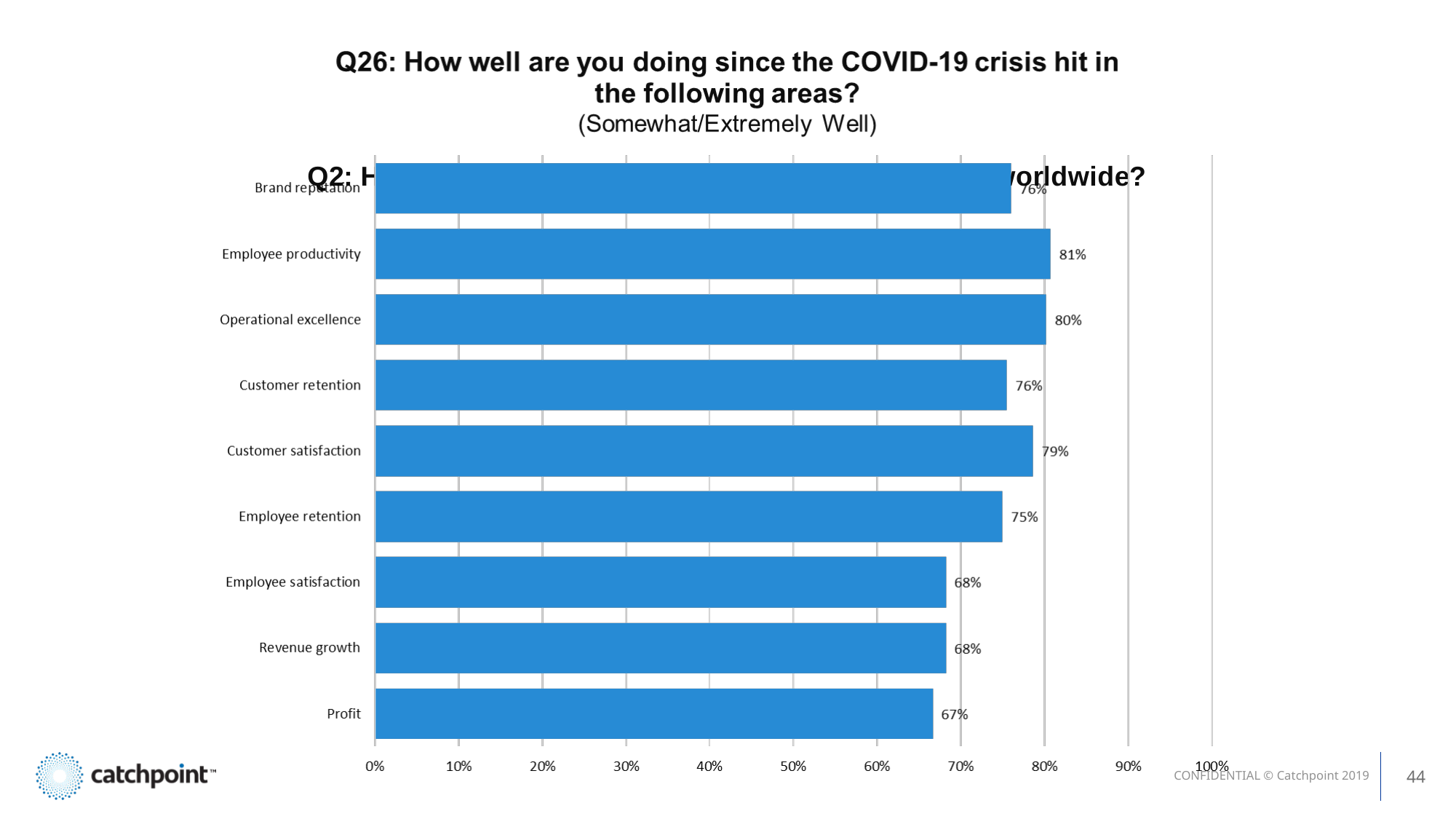
Is the value for Revenue growth greater or less than 70%? less What is the difference between Employee productivity and Profit? 14% What kind of chart is shown on the slide? Bar chart What percentage is shown for Employee productivity? 81% What percentage is shown for Customer satisfaction? 79% How many areas are shown in the chart? 9 Which area has the lowest percentage? Profit What is the difference between Customer satisfaction and Employee retention? 4% What is the value for Profit? 67% Which is larger, Customer retention or Employee satisfaction? Customer retention Which area has the highest percentage? Employee productivity What is the value for Operational excellence? 80%